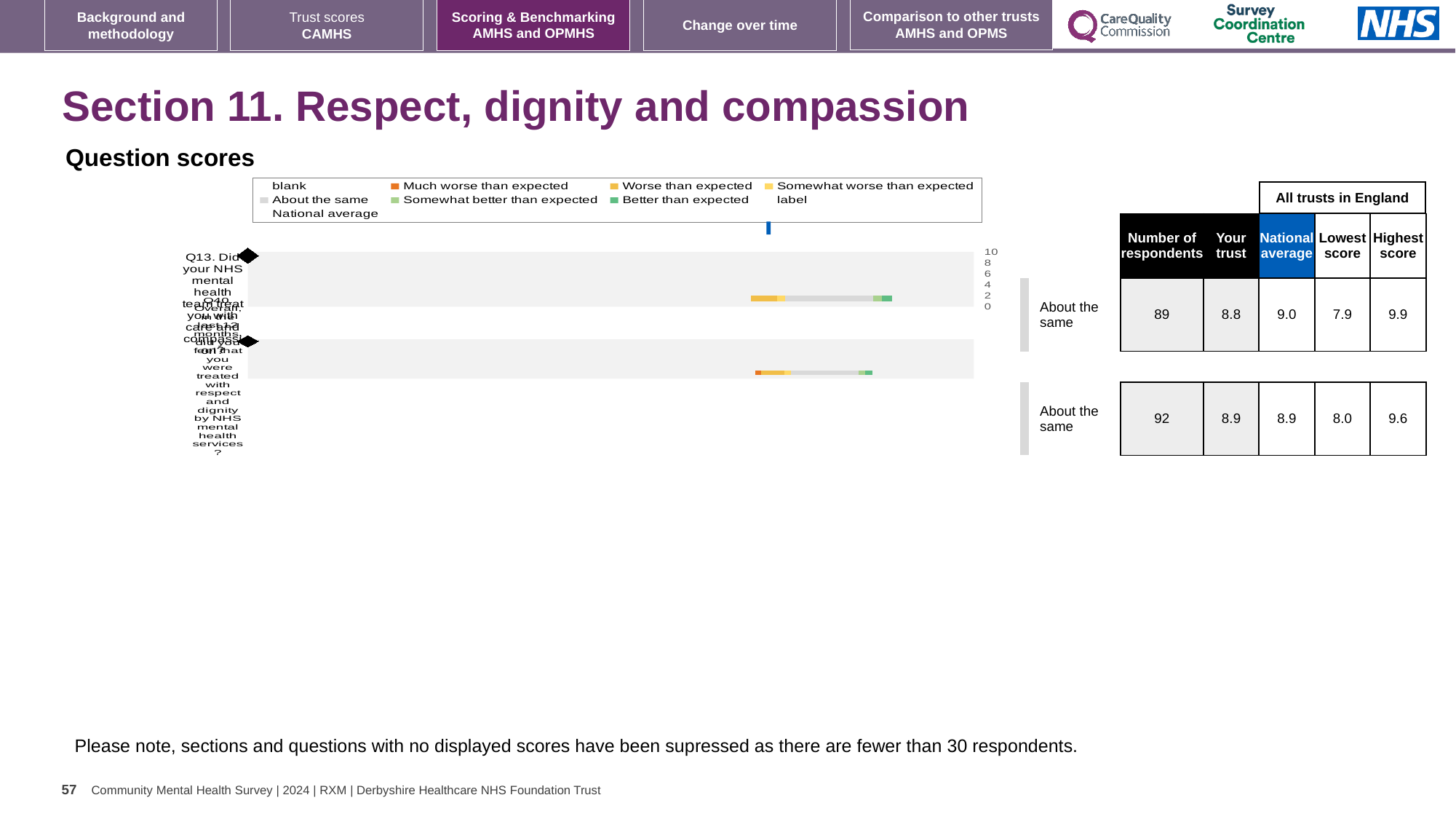
Which question has the higher 'Your trust' score in the table, Q13 or Q10? Q10 What is the lowest score across all trusts in England for Q10, as shown in the table? 8.0 How many questions (rows) are plotted in the question scores chart? 2 Which question has more respondents, Q13 or Q10? Q10 In the table beside the chart, what is the 'Your trust' score for Q13 (care and compassion)? 8.8 What is the difference between the highest score and the lowest score for Q13 in the table? 2.0 How many respondents are listed for Q13 in the table beside the chart? 89 What type of chart is used to show the question scores on this slide? bar chart What is the highest score across all trusts in England for Q13, as shown in the table? 9.9 In the table beside the chart, what is the national average for Q10 (respect and dignity)? 8.9 How many entries does the legend of the question scores chart list? 9 What benchmark category is shown next to the chart for Q13? About the same